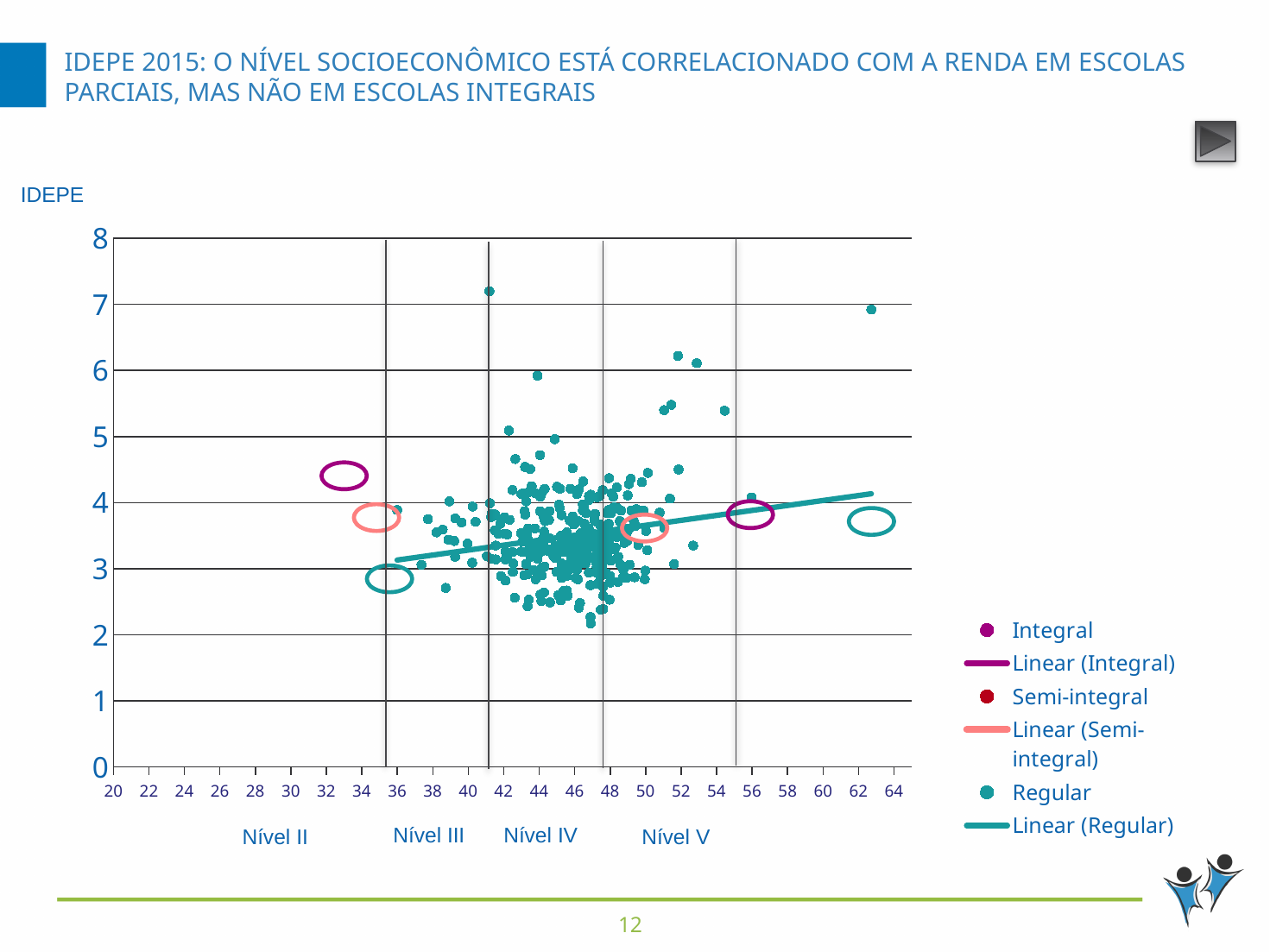
What kind of chart is shown on the slide? Scatter chart What label is given to the vertical axis of the chart? IDEPE Which series in the legend is shown in teal? Regular Are most of the Regular points greater or less than 5 on the IDEPE axis? less Does the Linear (Regular) trend line rise or fall as the x-axis value increases? Rises Is the highest plotted Regular point greater or less than 7 on the IDEPE axis? greater How many entries does the legend list? 6